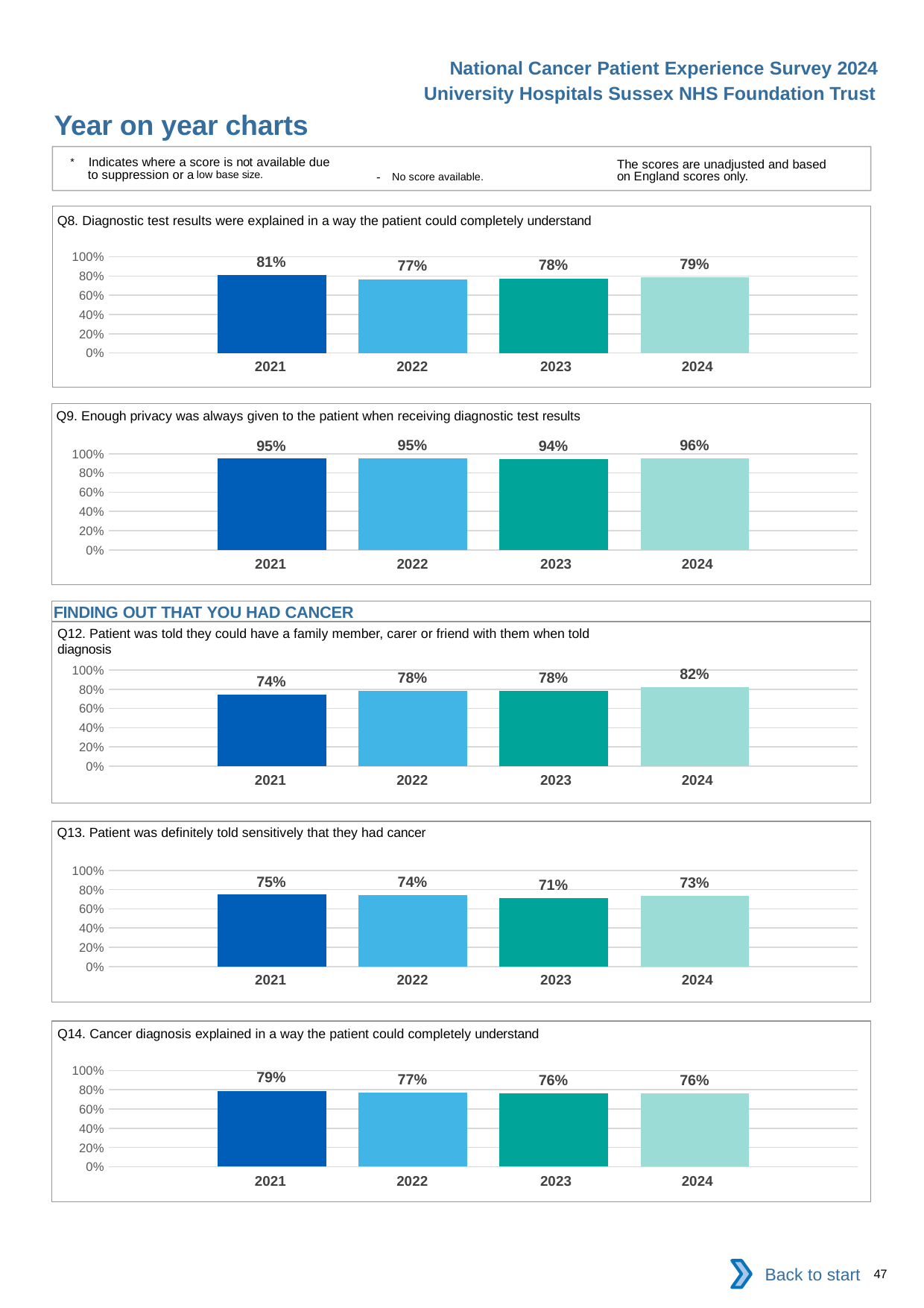
In the Q13 chart (Patient was definitely told sensitively that they had cancer), what is the difference between the 2021 and 2023 values? 4% In the Q14 chart (Cancer diagnosis explained in a way the patient could completely understand), what is the value for 2023? 76% In the Q9 chart (Enough privacy was always given to the patient when receiving diagnostic test results), which year has the highest value? 2024 In the Q14 chart (Cancer diagnosis explained in a way the patient could completely understand), is the value for 2021 greater or less than 60%? greater What is the section heading shown above the Q12 chart? FINDING OUT THAT YOU HAD CANCER In the Q8 chart (Diagnostic test results were explained in a way the patient could completely understand), what is the value for 2021? 81% How many years are plotted in the Q8 chart (Diagnostic test results were explained in a way the patient could completely understand)? 4 In the Q12 chart (Patient was told they could have a family member, carer or friend with them when told diagnosis), which year has the highest value? 2024 What kind of chart is the Q13 chart (Patient was definitely told sensitively that they had cancer)? Bar chart In the Q13 chart (Patient was definitely told sensitively that they had cancer), which is larger, the value for 2021 or the value for 2023? 2021 In the Q9 chart (Enough privacy was always given to the patient when receiving diagnostic test results), which year has the lowest value? 2023 In the Q12 chart (Patient was told they could have a family member, carer or friend with them when told diagnosis), what is the difference between the 2024 and 2021 values? 8%